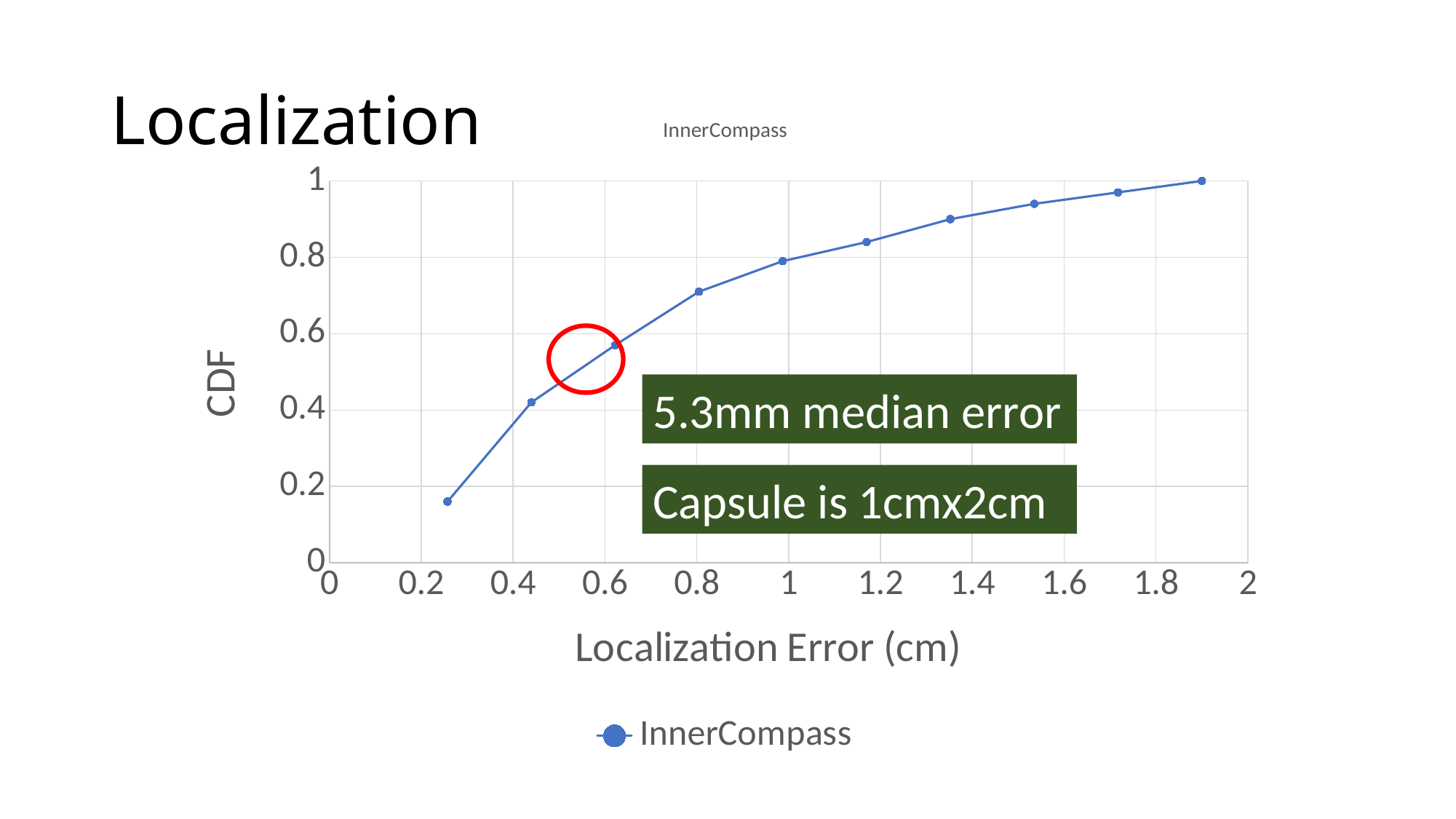
How many data points are plotted on the InnerCompass line? 10 Is the CDF value at a localization error of about 0.8 cm greater or less than 0.6? greater Which has the higher CDF value: the point near 0.44 cm or the point near 1.17 cm? the point near 1.17 cm What is the highest value shown on the y axis (CDF)? 1 How many series does the legend list? 1 Is the CDF value at a localization error of about 1.35 cm greater or less than 0.8? greater What is the title of the chart? InnerCompass What kind of chart is shown on the slide? line chart What CDF value does the rightmost point of the curve reach? 1 Does the CDF rise or fall as Localization Error increases along the x axis? rise What is the label of the x axis? Localization Error (cm) Is the CDF value of the leftmost point (near 0.26 cm) greater or less than 0.2? less